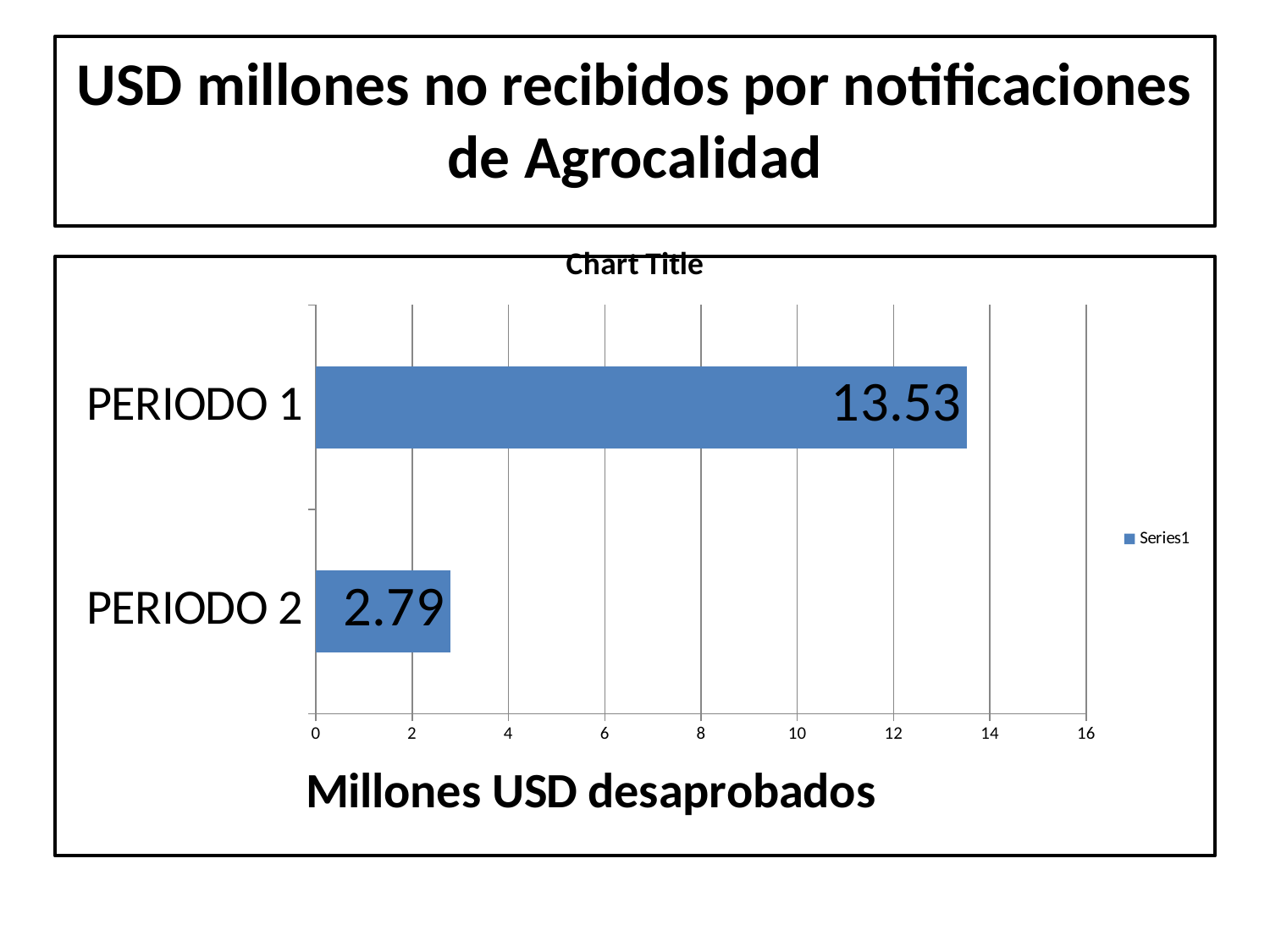
Which category has the highest value? PERIODO 1 What is the label of the horizontal axis? Millones USD desaprobados What kind of chart is shown on the slide? bar chart What is the value for PERIODO 2? 2.79 What is the value for PERIODO 1? 13.53 Which category has the lowest value? PERIODO 2 Which is larger, the value for PERIODO 1 or PERIODO 2? PERIODO 1 What is the difference between the values for PERIODO 1 and PERIODO 2? 10.74 How many categories are shown in the chart? 2 Is the value for PERIODO 1 greater or less than 12? greater How many series does the legend list? 1 Is the value for PERIODO 2 greater or less than 4? less